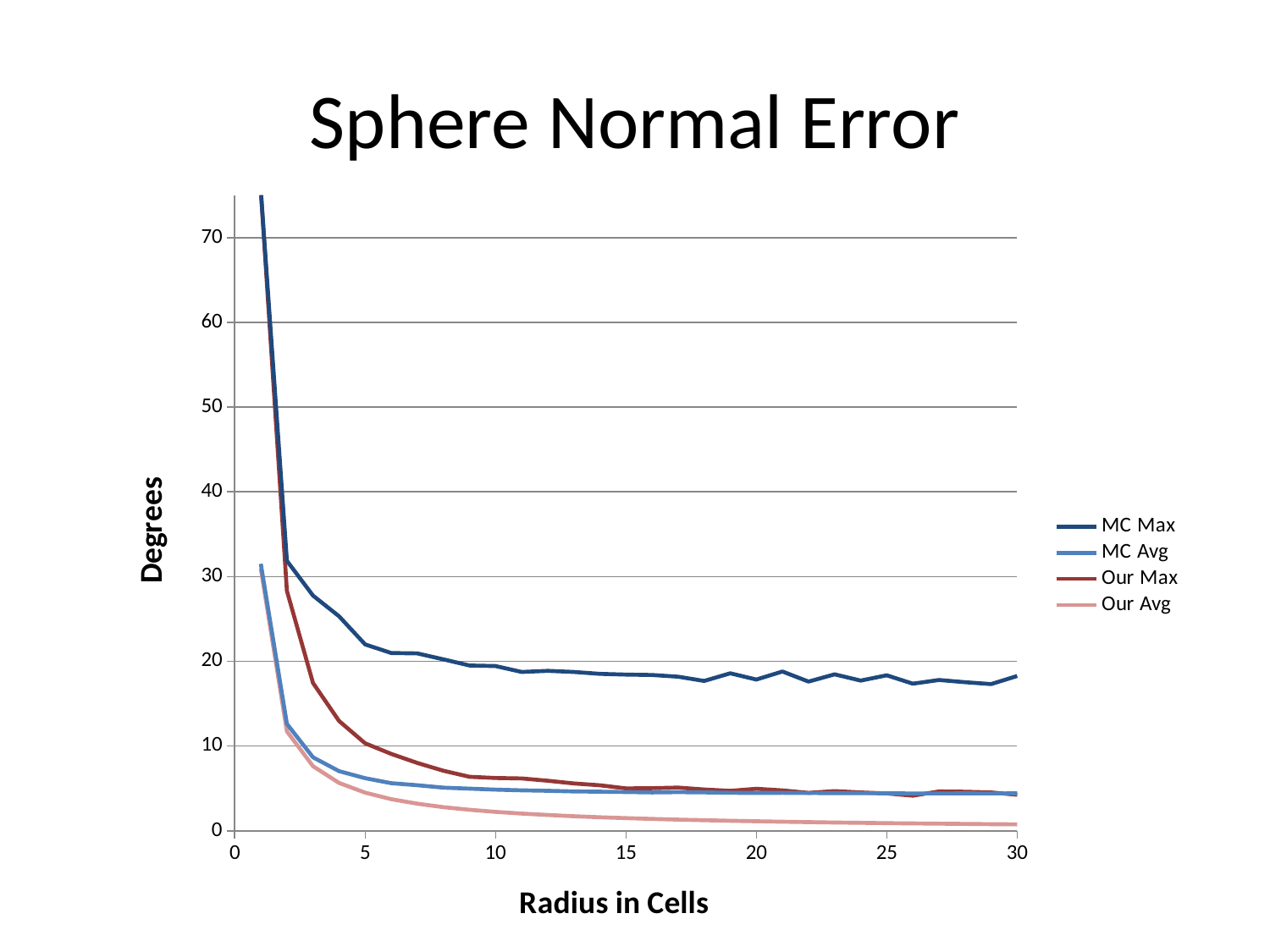
Which series has the highest values across the chart? MC Max What is the title of the chart? Sphere Normal Error Is the value for Our Max at a radius of 10 cells greater or less than 10? less At a radius of 5 cells, which is larger: Our Max or MC Avg? Our Max Is the value for MC Max at a radius of 30 cells greater or less than 10? greater Do the values of the MC Max series rise or fall as the radius increases? fall Is the value for Our Avg at a radius of 30 cells greater or less than 10? less What is the label of the x axis? Radius in Cells What kind of chart is shown on the slide? line chart Which series has the lowest values across the chart? Our Avg How many series does the legend list? 4 At a radius of 30 cells, which is larger: MC Max or Our Avg? MC Max